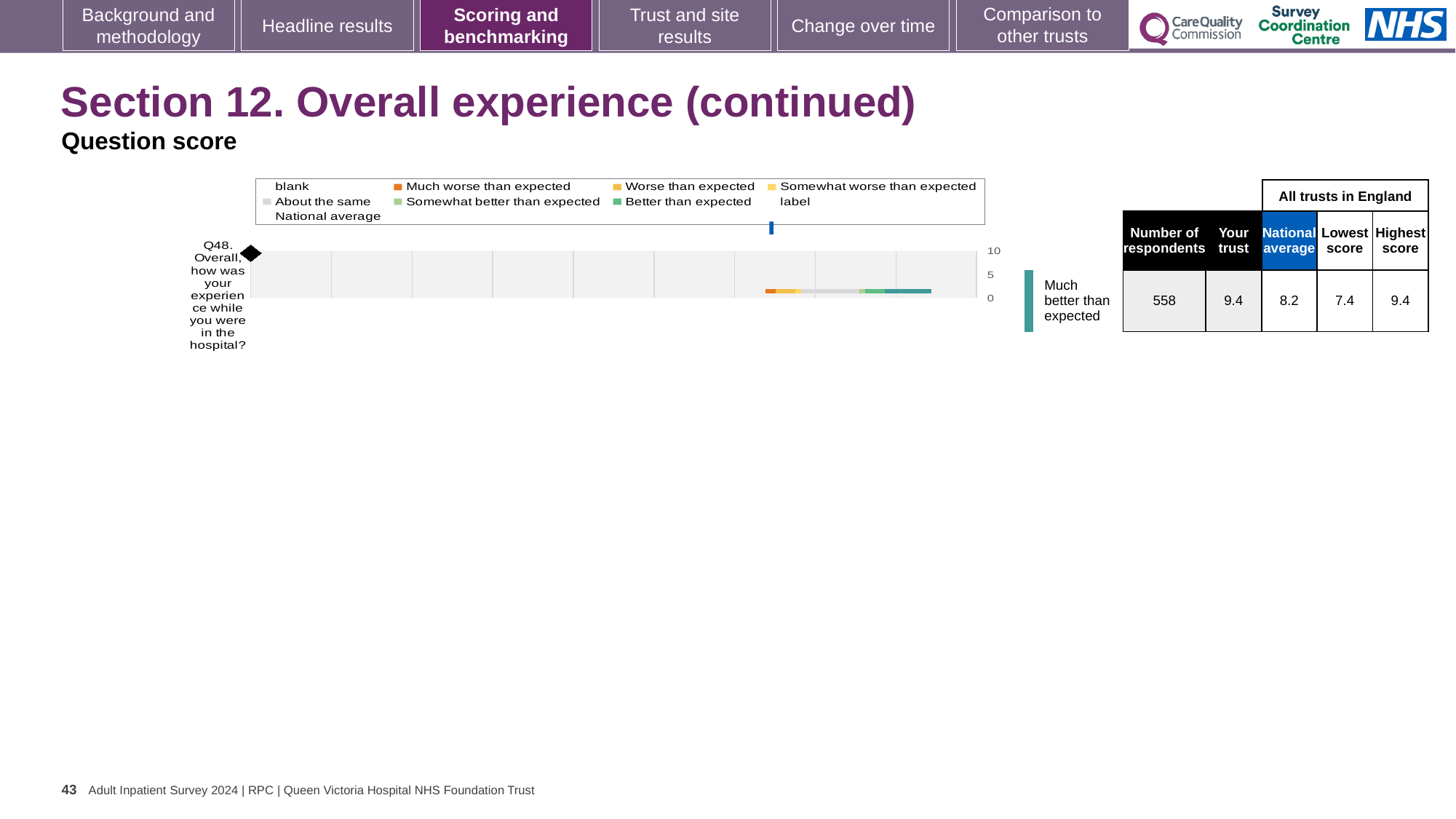
What is the 'Your trust' score for Q48? 9.4 By how much does the 'Your trust' score for Q48 exceed the national average? 1.2 How many respondents answered Q48? 558 What is the difference between the highest and lowest scores for Q48 across all trusts in England? 2.0 How many questions are plotted on the chart? 1 Which is larger for Q48, the 'Your trust' score or the national average? Your trust What is the national average score for Q48? 8.2 What is the highest score among all trusts in England for Q48? 9.4 What is the lowest score among all trusts in England for Q48? 7.4 What kind of chart is shown on the slide? bar chart Which benchmarking category is shown for Q48? Much better than expected Which question is plotted on the chart? Q48. Overall, how was your experience while you were in the hospital?